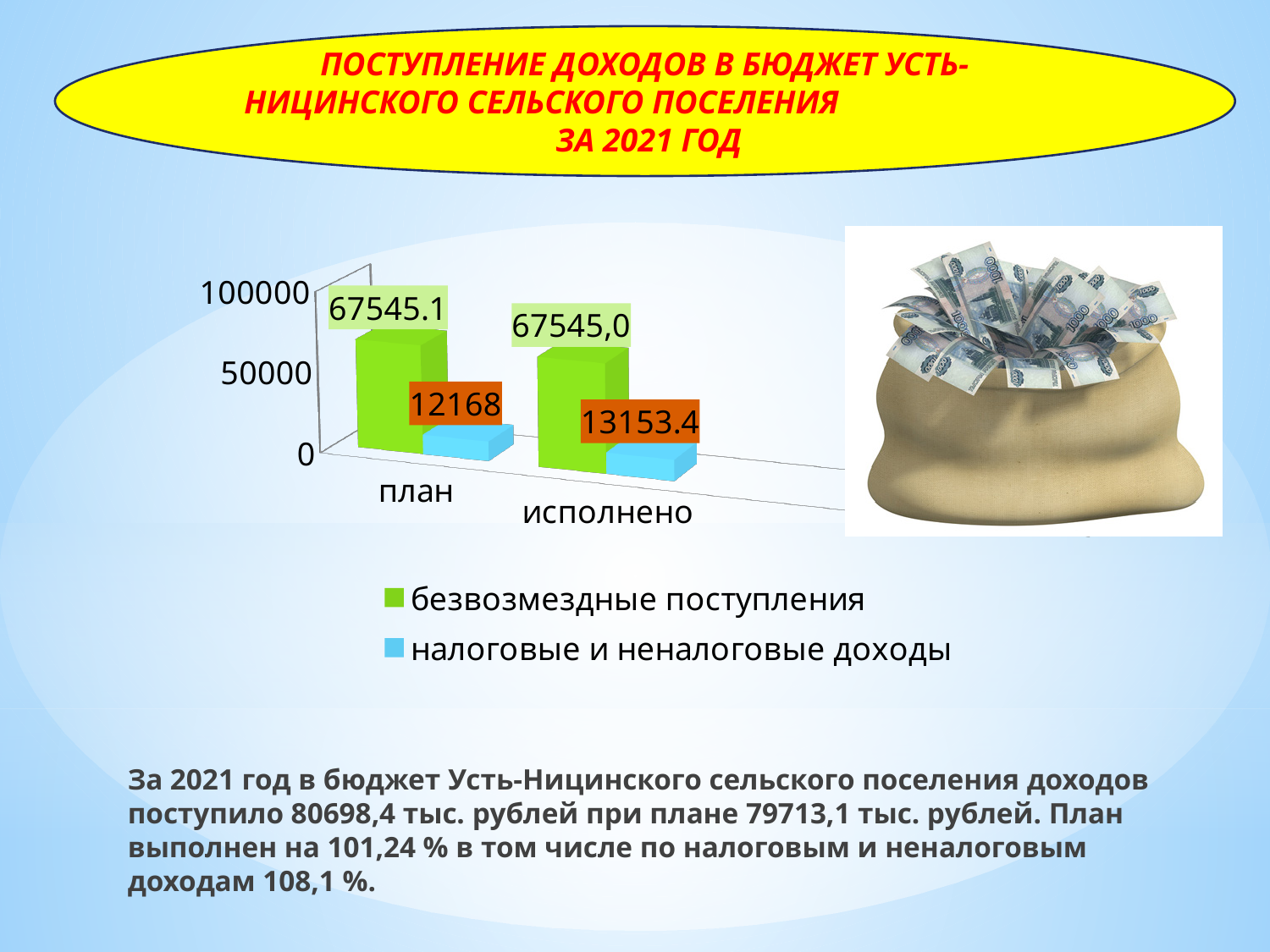
Is the value of безвозмездные поступления for исполнено greater or less than 50000? greater What is the value of безвозмездные поступления for план? 67545.1 Which category has the higher value for налоговые и неналоговые доходы, план or исполнено? исполнено What is the value of безвозмездные поступления for исполнено? 67545,0 How many categories are shown on the x axis of the chart? 2 What is the value of налоговые и неналоговые доходы for план? 12168 For план, which series has the larger value: безвозмездные поступления or налоговые и неналоговые доходы? безвозмездные поступления What kind of chart is shown on the slide? bar chart Which colour represents безвозмездные поступления in the chart legend? green What is the difference between налоговые и неналоговые доходы for исполнено and for план? 985.4 What is the value of налоговые и неналоговые доходы for исполнено? 13153.4 How many series does the chart legend list? 2